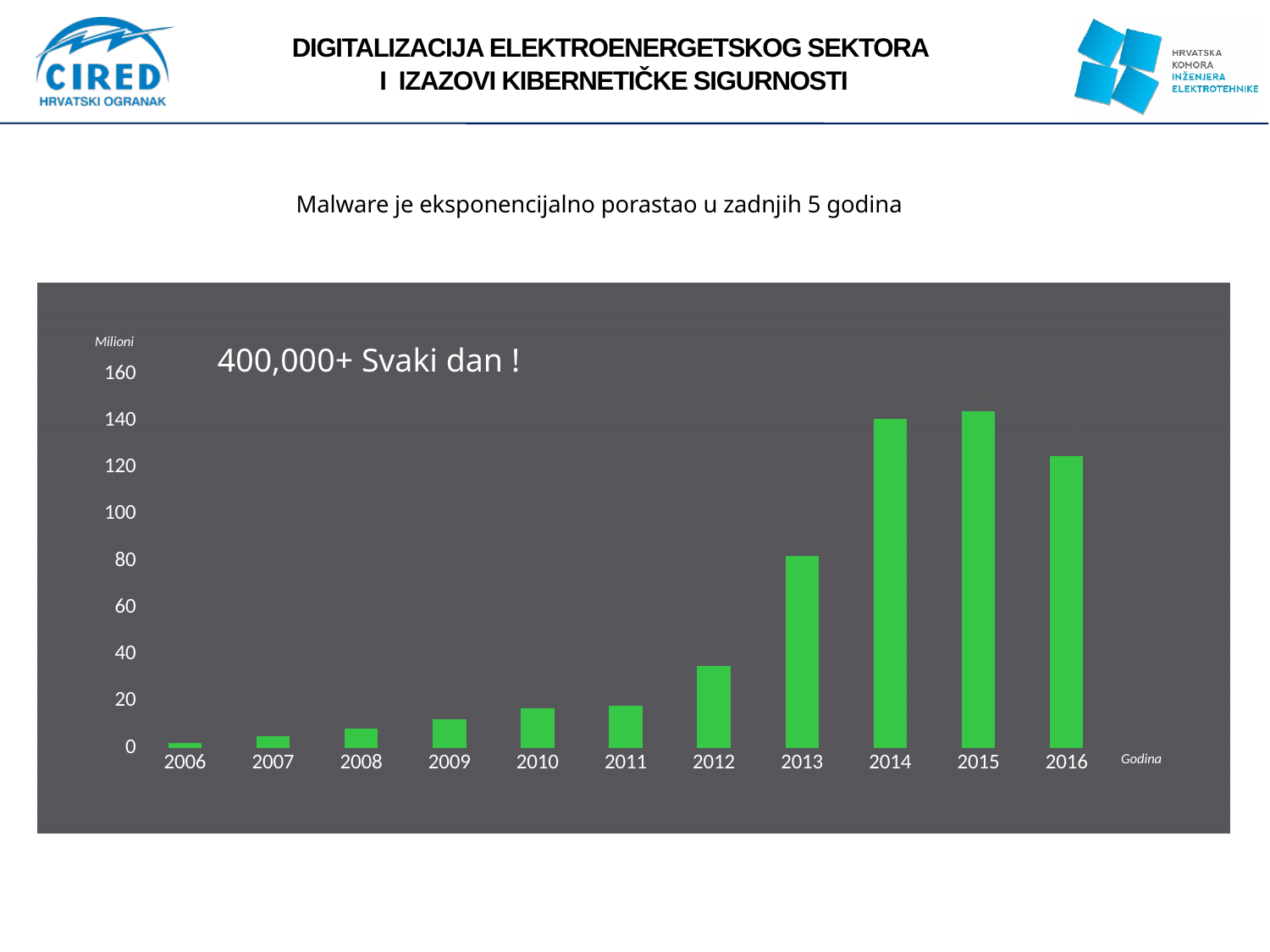
Is the value for 2014 greater or less than 120? greater What label is shown on the x axis of the chart? Godina Is the value for 2010 greater or less than 20? less Is the value for 2016 greater or less than 100? greater Do the values generally rise or fall from 2006 to 2015? rise How many years are shown on the x axis of the chart? 11 Which year has the larger value, 2012 or 2013? 2013 Which year has the lowest value in the chart? 2006 Which year has the larger value, 2013 or 2016? 2016 What kind of chart is shown on the slide? bar chart